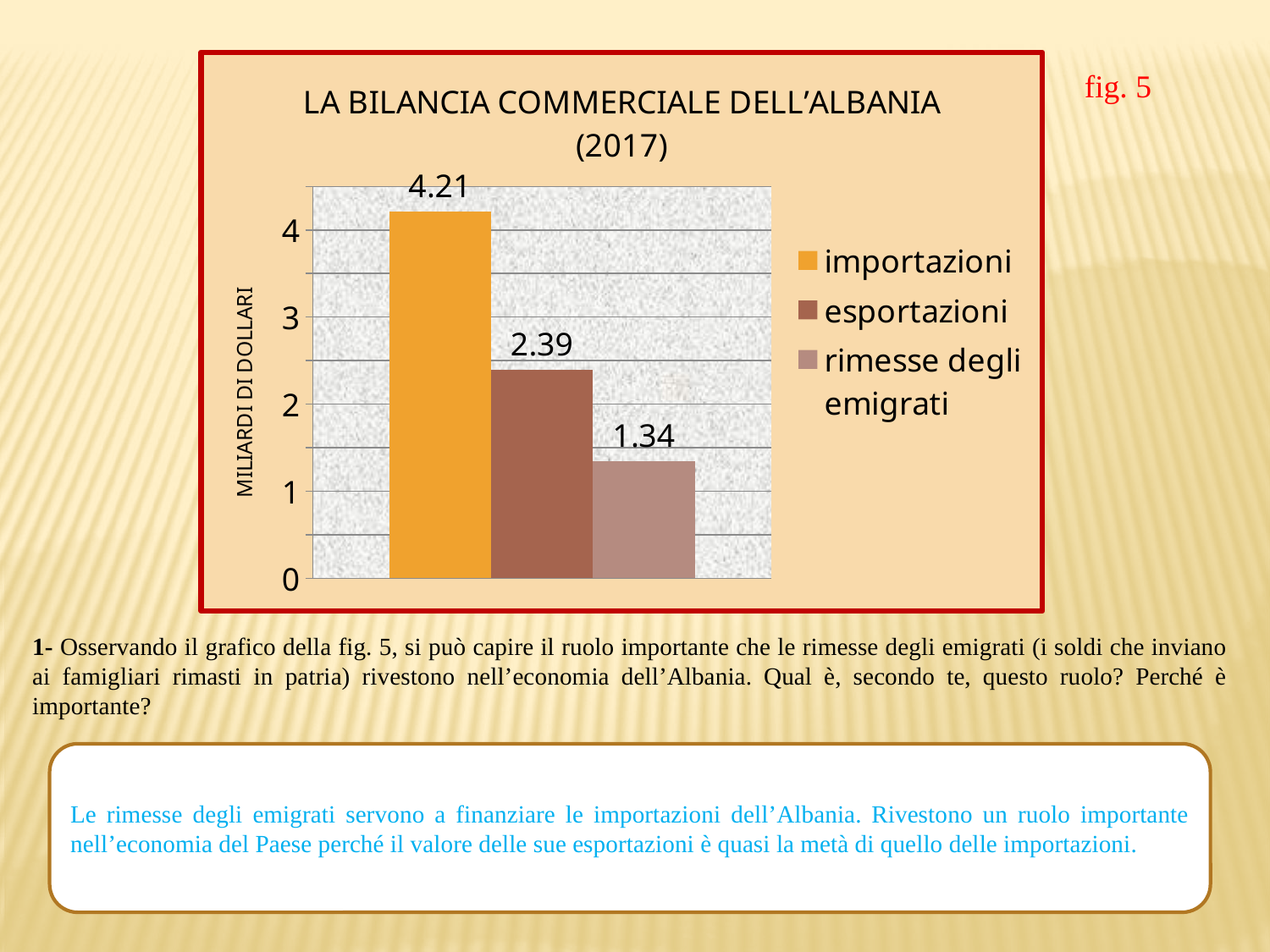
What is the value for importazioni? 4.21 What is the value for esportazioni? 2.39 Which is larger, esportazioni or rimesse degli emigrati? esportazioni What kind of chart is shown? bar chart Is the value for importazioni greater or less than 4? greater What is the title of the chart? LA BILANCIA COMMERCIALE DELL'ALBANIA (2017) Which series has the lowest value? rimesse degli emigrati What is the difference between esportazioni and rimesse degli emigrati? 1.05 What is the value for rimesse degli emigrati? 1.34 What is the difference between importazioni and esportazioni? 1.82 Which series has the highest value? importazioni How many series does the legend list? 3